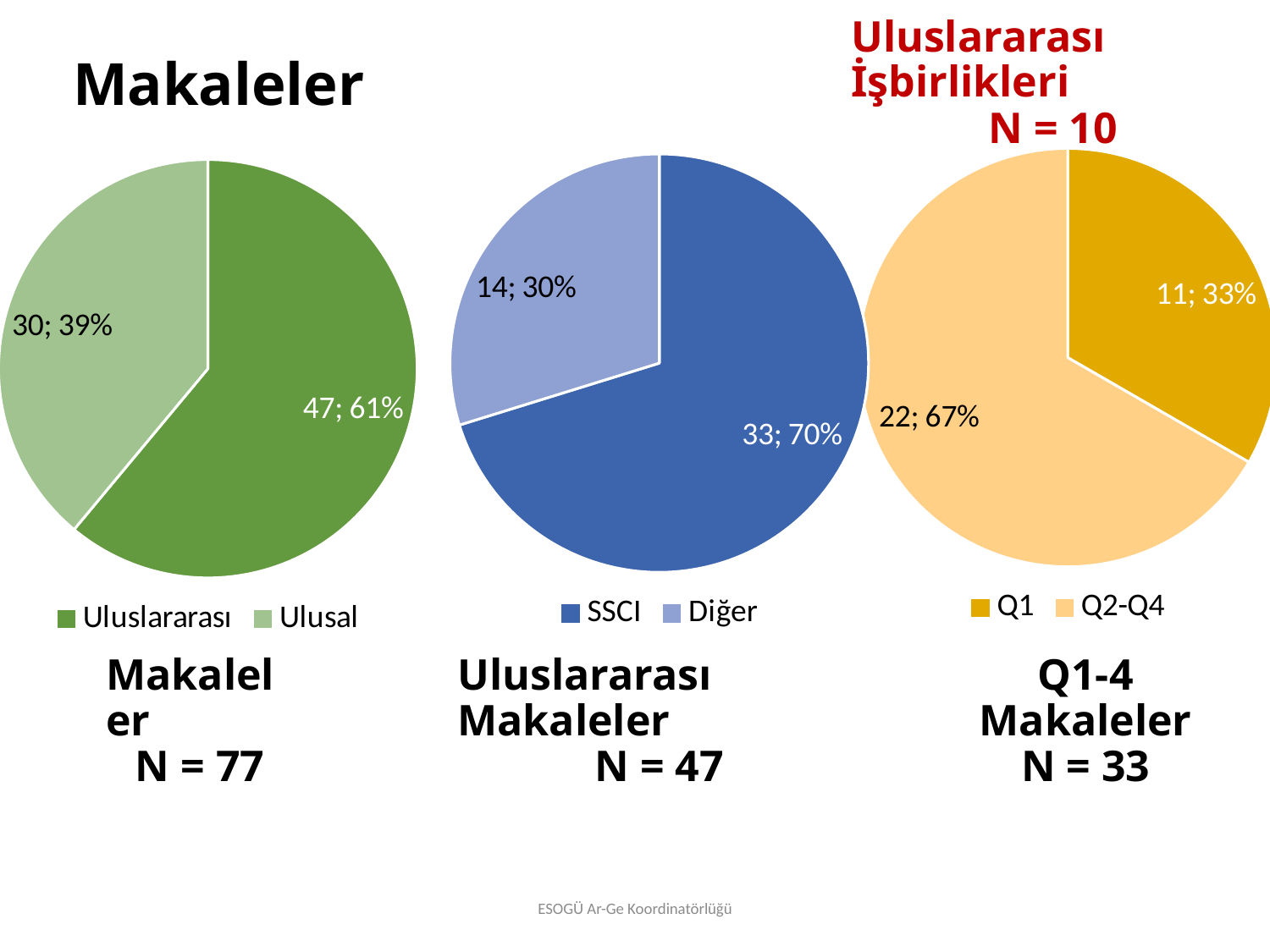
In the right pie chart (Q1-4 Makaleler, N = 33), what share of the pie does Q1 take? 33% In the left pie chart (Makaleler, N = 77), what is the difference between the Uluslararası and Ulusal values? 17 In the left pie chart (Makaleler, N = 77), what share of the pie does Ulusal take? 39% In the middle pie chart (Uluslararası Makaleler, N = 47), what share of the pie does Diğer take? 30% How many series does the legend of the middle pie chart list? 2 In the right pie chart (Q1-4 Makaleler, N = 33), what is the value for Q2-Q4? 22 In the left pie chart (Makaleler, N = 77), which category is the largest? Uluslararası In the left pie chart (Makaleler, N = 77), what is the value for Uluslararası? 47 In the middle pie chart (Uluslararası Makaleler, N = 47), what is the value for SSCI? 33 In the middle pie chart (Uluslararası Makaleler, N = 47), what is the difference between the SSCI and Diğer values? 19 In the right pie chart (Q1-4 Makaleler, N = 33), which category is the smallest? Q1 What kind of chart is the right chart (Q1-4 Makaleler, N = 33)? Pie chart